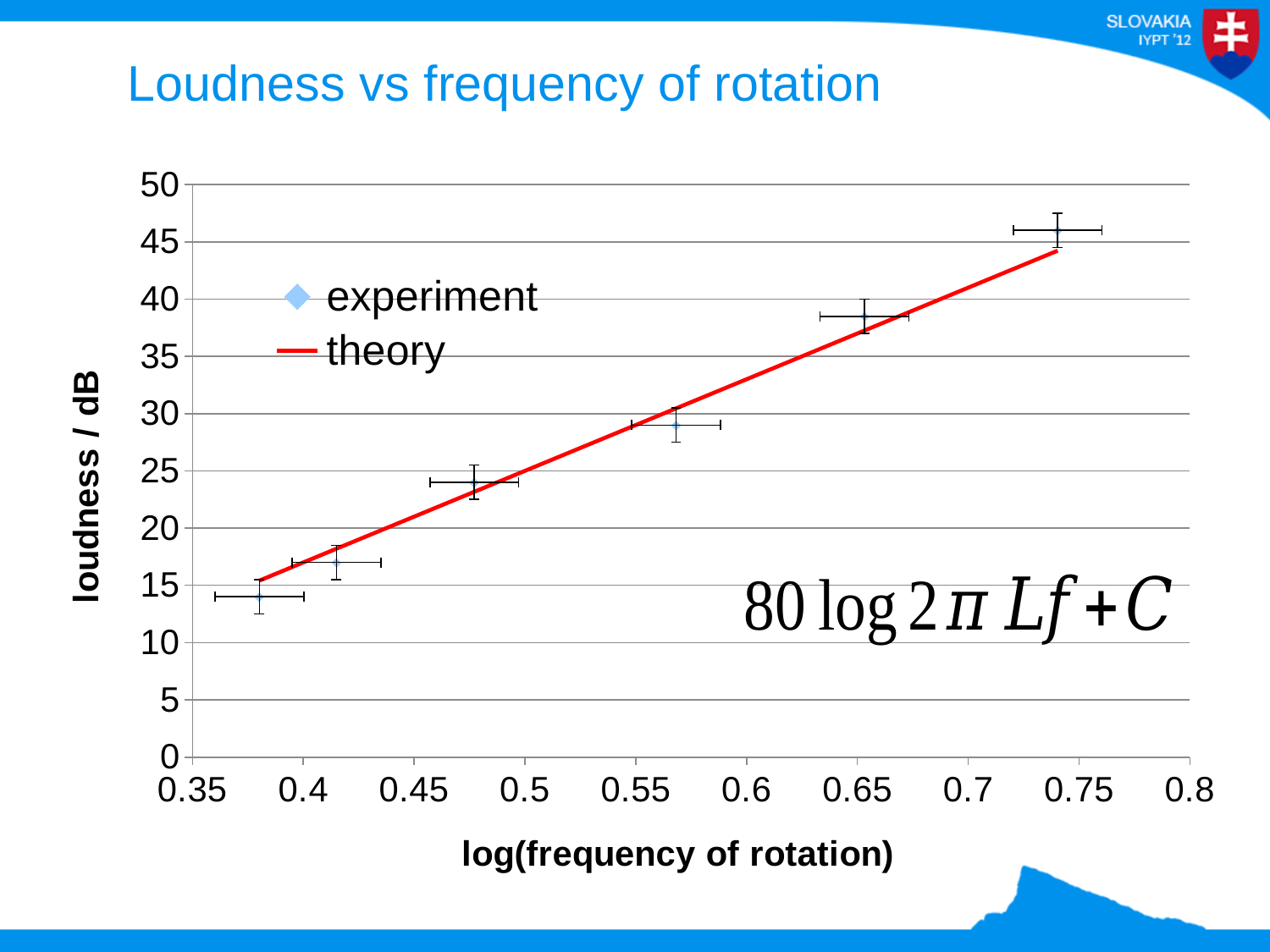
Is the loudness of the experiment point near log(frequency) 0.48 greater or less than 20 dB? greater Which experiment point has the higher loudness, the leftmost or the rightmost? the rightmost What is the title of the chart? Loudness vs frequency of rotation What label is on the y axis of the chart? loudness / dB How many experiment data points are plotted? 6 How many series does the legend list? 2 What kind of chart is shown on the slide? scatter chart Is the loudness of the experiment point near log(frequency) 0.65 greater or less than 35 dB? greater Is the loudness of the leftmost experiment point greater or less than 20 dB? less Does loudness rise or fall as log(frequency of rotation) increases? rise